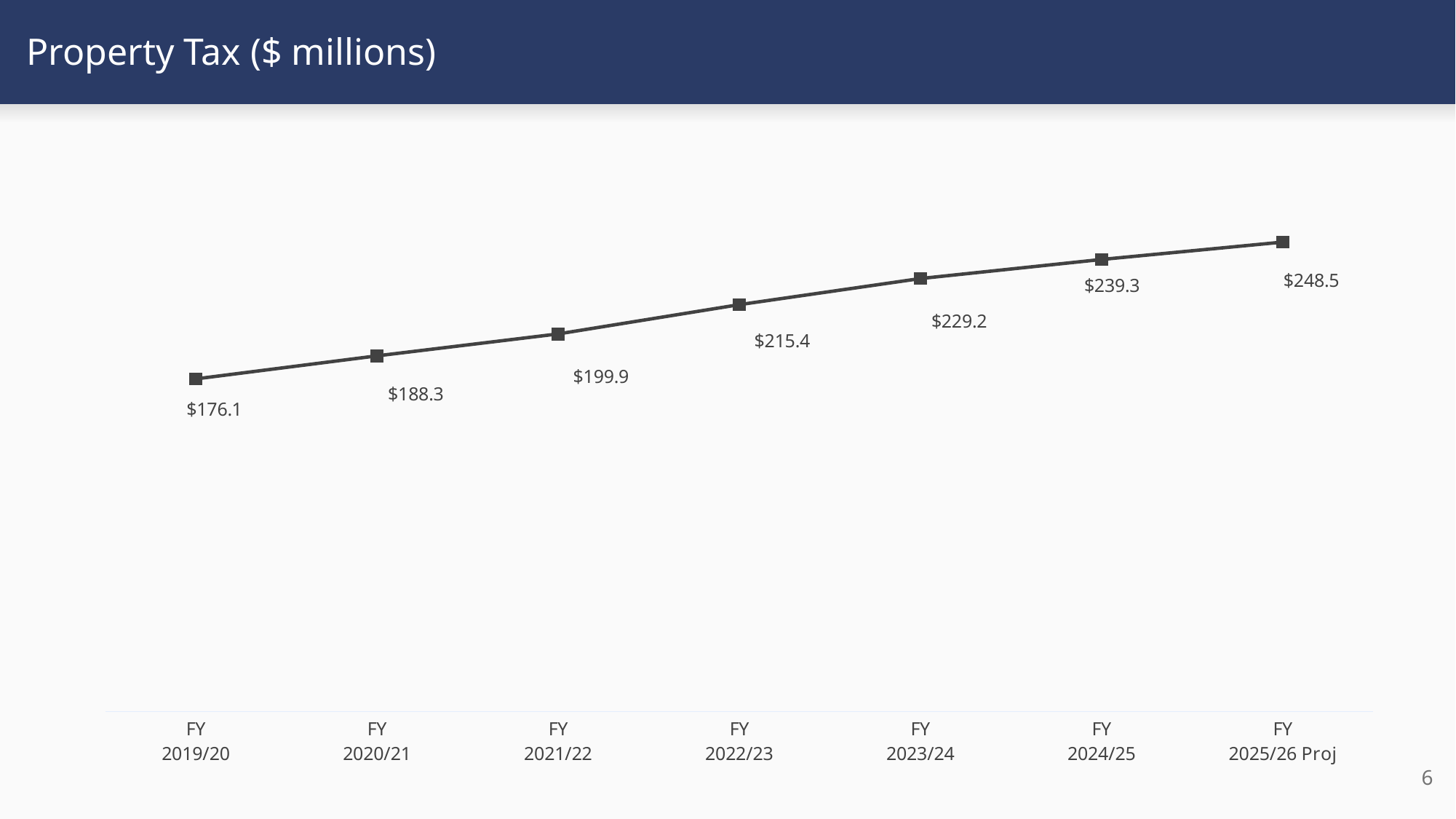
Which fiscal year has the highest property tax value? FY 2025/26 Proj Which is larger, the property tax value for FY 2020/21 or FY 2021/22? FY 2021/22 What is the projected property tax value for FY 2025/26? $248.5 What is the property tax value for FY 2022/23? $215.4 What is the property tax value for FY 2024/25? $239.3 Do the property tax values rise or fall from FY 2019/20 to FY 2025/26 Proj? Rise What kind of chart is shown on the slide? Line chart What is the difference between the property tax values for FY 2025/26 Proj and FY 2019/20? $72.4 Which fiscal year has the lowest property tax value? FY 2019/20 What is the difference between the property tax values for FY 2023/24 and FY 2022/23? $13.8 What is the property tax value for FY 2019/20? $176.1 How many fiscal years are plotted on the chart? 7